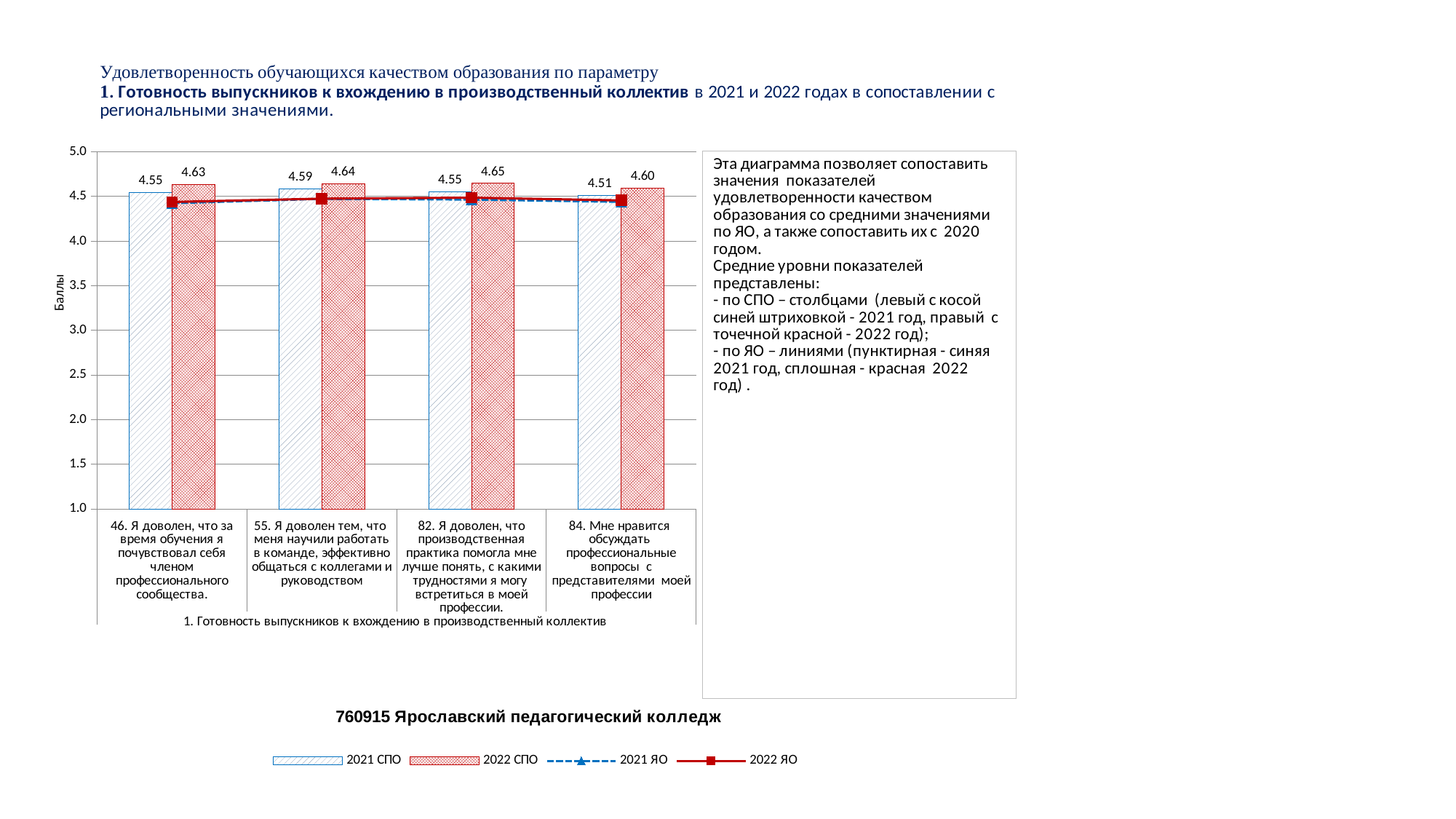
Which is larger for category 55: the 2021 СПО value or the 2022 СПО value? 2022 СПО What is the difference between the 2022 СПО and 2021 СПО values for category 84? 0.09 How many categories are shown on the x axis? 4 What is the 2021 СПО value for category 46 (Я доволен, что за время обучения я почувствовал себя членом профессионального сообщества)? 4.55 What is the 2022 СПО value for category 55 (Я доволен тем, что меня научили работать в команде)? 4.64 What is the difference between the 2022 СПО and 2021 СПО values for category 82? 0.10 How many series does the legend list? 4 What is the 2022 СПО value for category 82 (производственная практика помогла мне лучше понять...)? 4.65 What is the 2021 СПО value for category 84 (Мне нравится обсуждать профессиональные вопросы...)? 4.51 Which category has the highest 2022 СПО value? 82. Я доволен, что производственная практика помогла мне лучше понять, с какими трудностями я могу встретиться в моей профессии. What is the label of the vertical axis? Баллы Which category has the lowest 2021 СПО value? 84. Мне нравится обсуждать профессиональные вопросы с представителями моей профессии